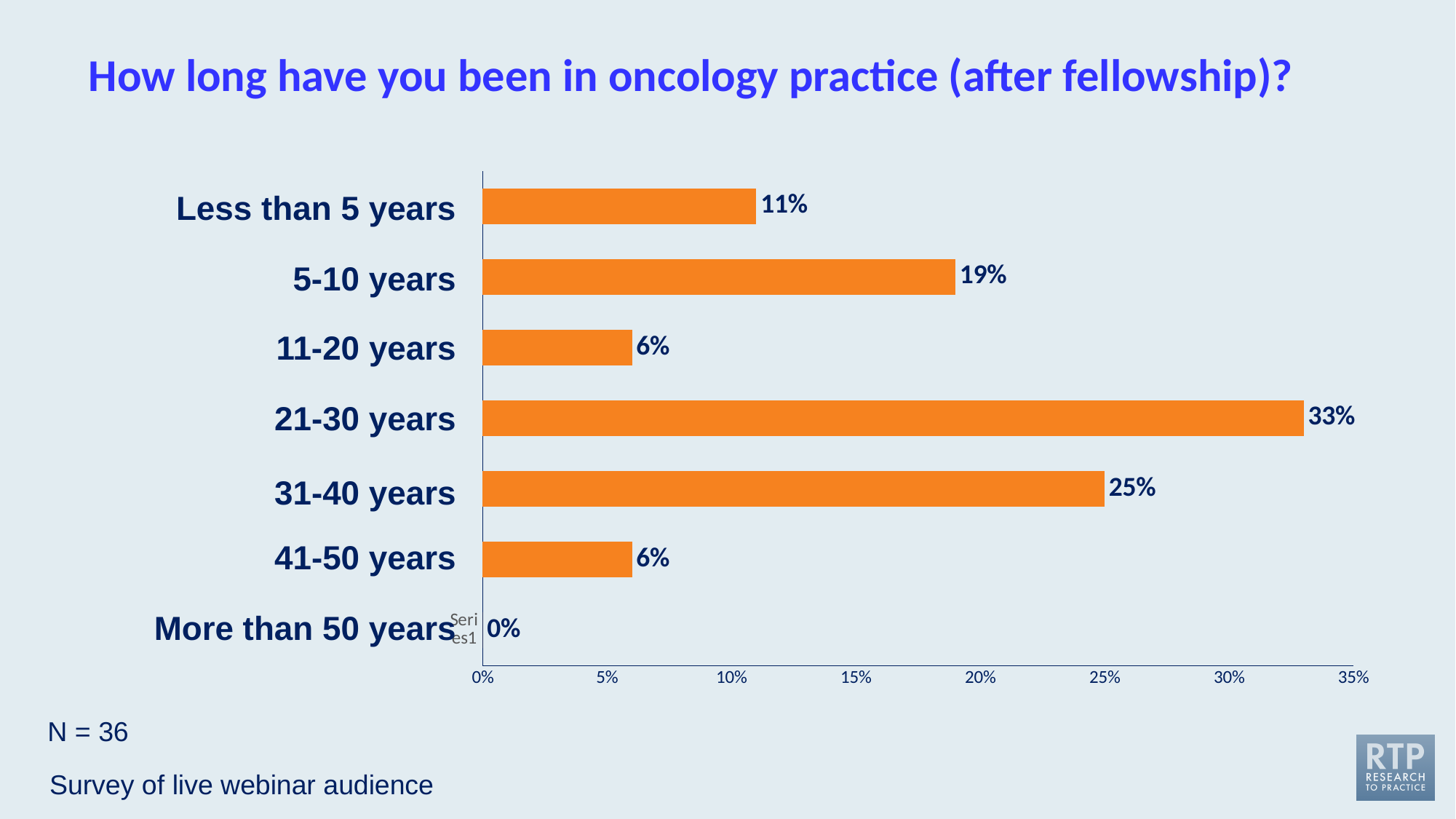
What percentage of respondents selected 'Less than 5 years'? 11% What percentage of respondents have been in oncology practice for 21-30 years? 33% Which category has the highest percentage? 21-30 years What is the value for 'More than 50 years'? 0% Which is larger, the value for '5-10 years' or the value for 'Less than 5 years'? 5-10 years What is the value shown for the '5-10 years' category? 19% What is the title of the chart? How long have you been in oncology practice (after fellowship)? What is the difference between the values for '21-30 years' and '31-40 years'? 8% What is the sample size (N) stated on the slide? 36 How many categories are shown on the chart? 7 What kind of chart is shown on the slide? Bar chart Which category has the lowest percentage? More than 50 years